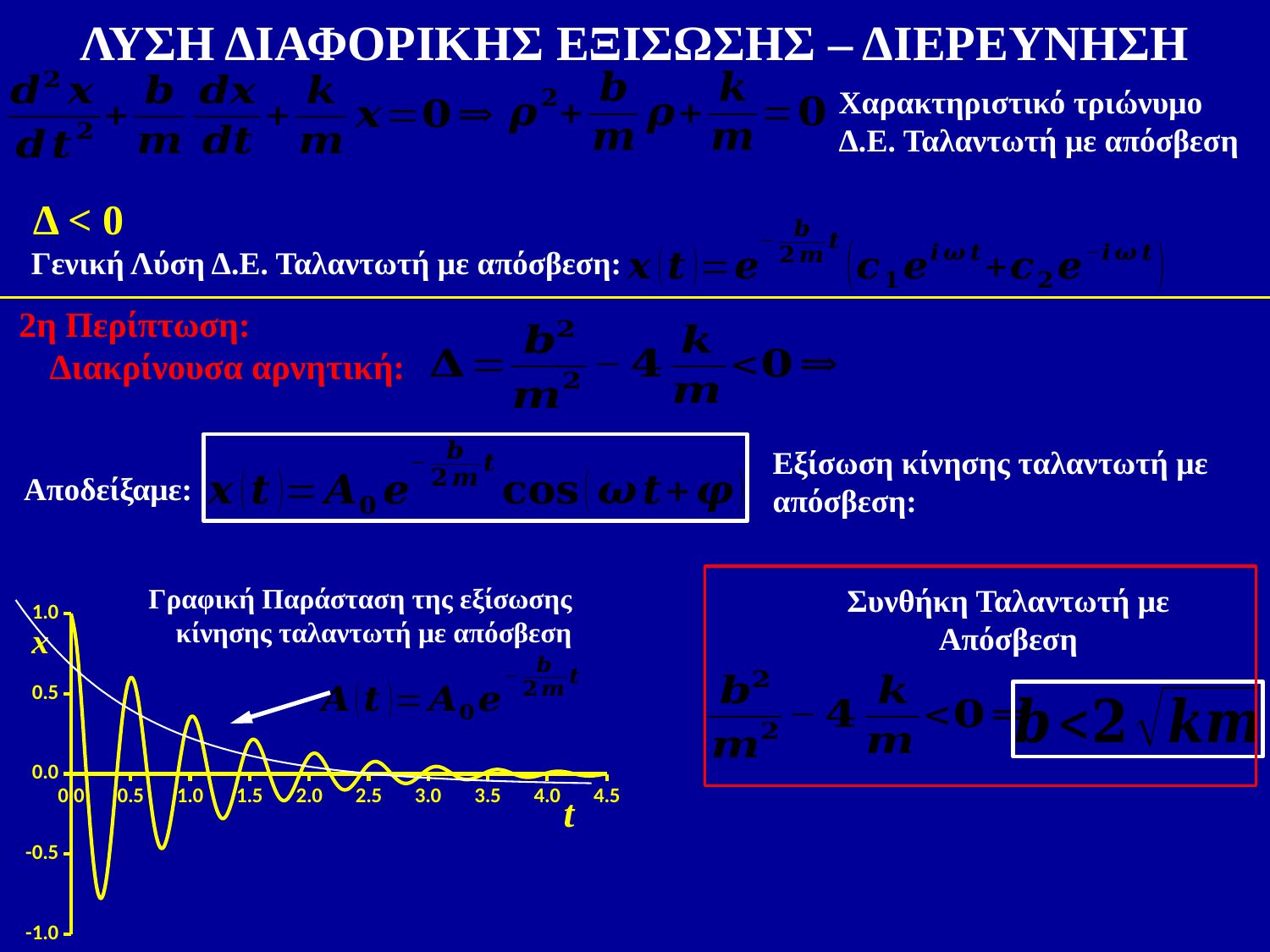
Does the amplitude of the oscillation in the chart increase or decrease as t increases? decrease How many curves are plotted on the chart? 2 What is the largest value shown on the horizontal (t) axis of the chart? 4.5 What is the lowest value shown on the vertical (x) axis of the chart? -1.0 What is the value of x at t = 0.0 on the chart? 1.0 What kind of chart is shown at the bottom left of the slide? line chart How many tick labels are shown on the horizontal (t) axis of the chart? 10 How many tick labels are shown on the vertical (x) axis of the chart? 5 What is the label of the vertical axis of the chart? x What is the label of the horizontal axis of the chart? t Is the first peak of the oscillating curve, at t = 0.0, greater or less than 0.5? greater Is the peak value of x near t = 4.0 greater or less than 0.5? less